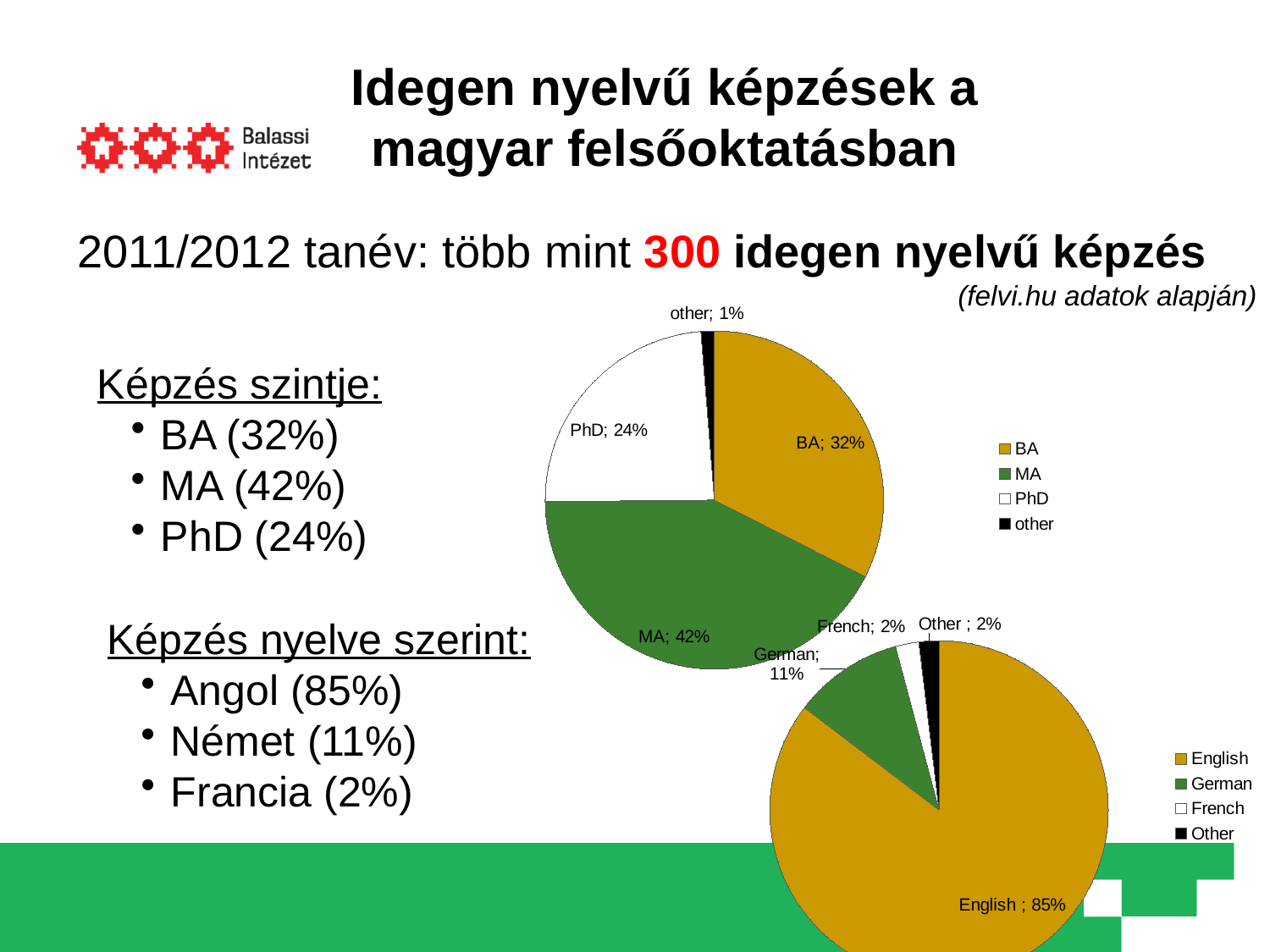
In the lower pie chart, what share does English have? 85% In the lower pie chart, which is larger, German or French? German In the upper pie chart, what is the difference between the MA and BA shares? 10% In the lower pie chart, what share does German have? 11% In the lower pie chart, which category has the largest slice? English What kind of chart is the upper chart on the slide? pie chart In the lower pie chart, what colour is the English slice? gold/yellow In the upper pie chart, what share does PhD have? 24% In the upper pie chart, which category has the smallest slice? other How many categories does the legend of the upper pie chart list? 4 In the upper pie chart, which category has the largest slice? MA In the upper pie chart, what share does MA have? 42%